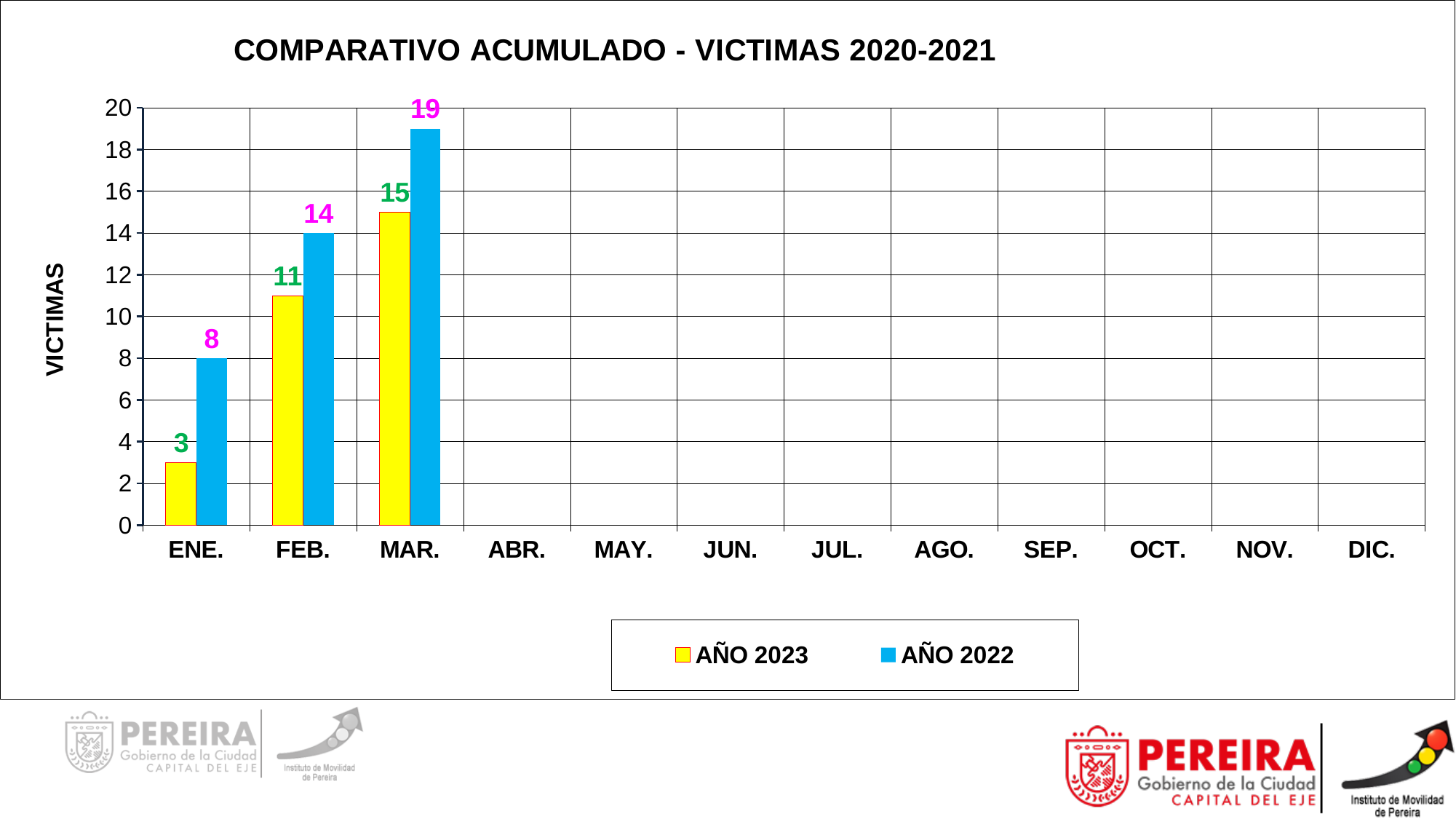
How many month categories are shown on the x axis? 12 Which is larger in MAR., AÑO 2023 or AÑO 2022? AÑO 2022 What is the value for AÑO 2023 in ENE.? 3 Which month has the highest value for AÑO 2022? MAR. Which month has the lowest value for AÑO 2023? ENE. What kind of chart is shown? bar chart What is the value for AÑO 2023 in FEB.? 11 What is the value for AÑO 2022 in MAR.? 19 Do the AÑO 2023 values rise or fall from ENE. to MAR.? rise How many series does the legend list? 2 What is the value for AÑO 2022 in ENE.? 8 What is the difference between AÑO 2022 and AÑO 2023 in FEB.? 3